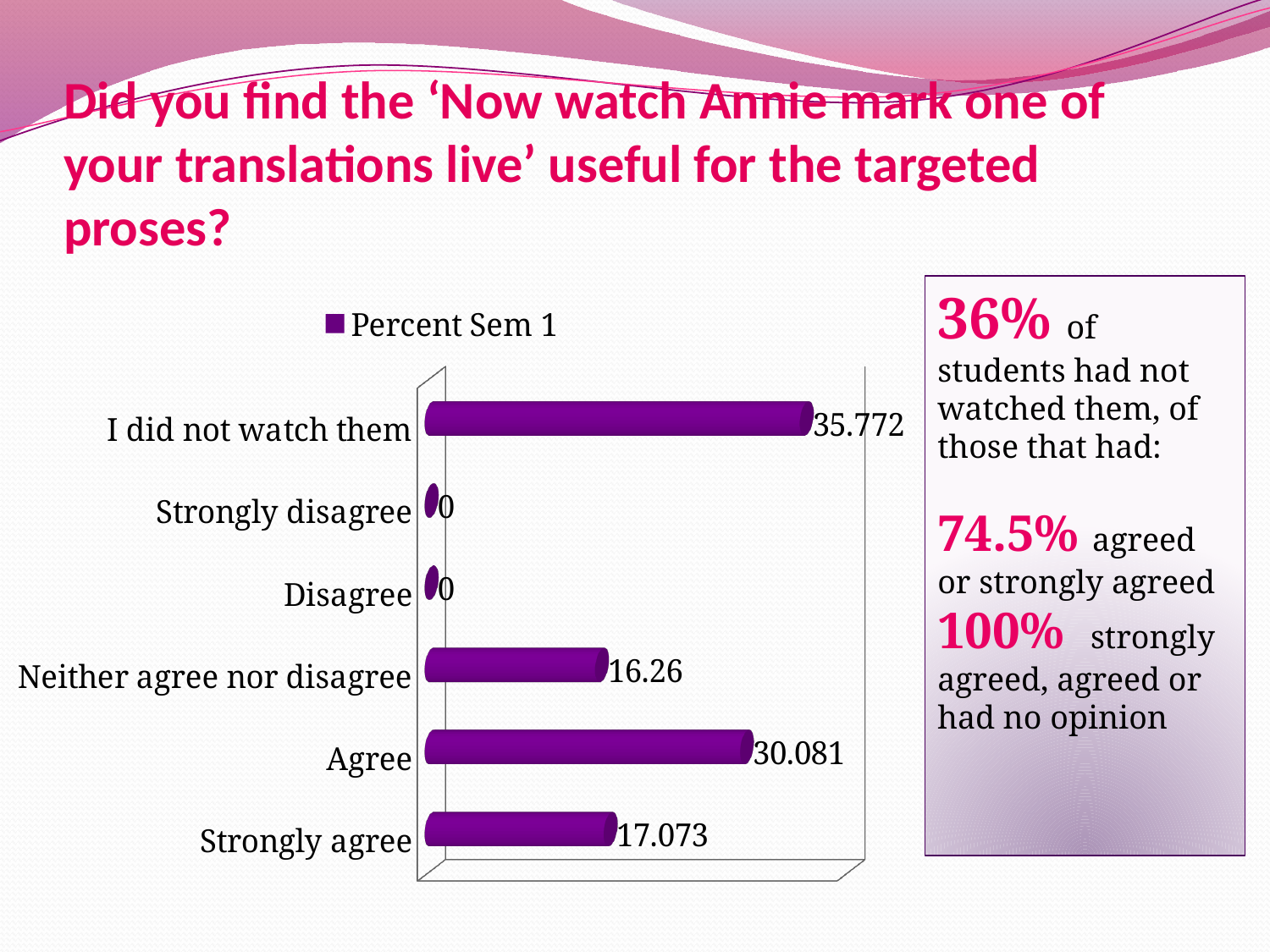
Which category has the highest value? I did not watch them What kind of chart is shown on the slide? Bar chart What is the value for 'Strongly agree'? 17.073 What is the value for 'I did not watch them'? 35.772 What is the difference between the values for 'Agree' and 'Strongly agree'? 13.008 What is the value for 'Neither agree nor disagree'? 16.26 What is the value for 'Strongly disagree'? 0 What is the value for 'Agree'? 30.081 How many series does the legend list? 1 What is the name of the series shown in the legend? Percent Sem 1 How many categories are shown on the chart? 6 Which is larger, the value for 'Agree' or the value for 'Neither agree nor disagree'? Agree